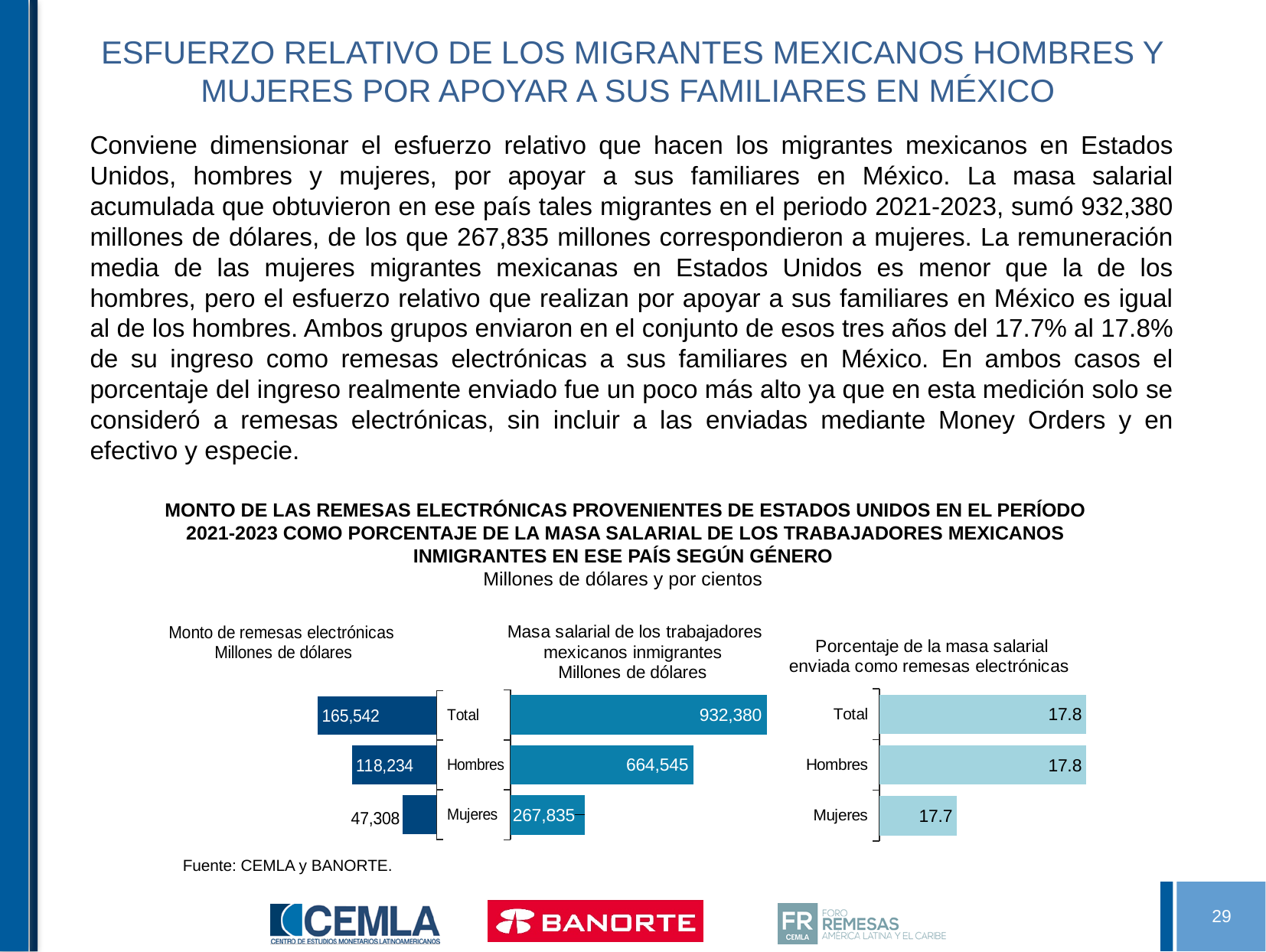
In the 'Monto de remesas electrónicas' chart, what is the value for Hombres? 118,234 In the 'Monto de remesas electrónicas' chart, which category has the lowest value? Mujeres In the 'Masa salarial de los trabajadores mexicanos inmigrantes' chart, what is the value for Mujeres? 267,835 In the 'Porcentaje de la masa salarial enviada como remesas electrónicas' chart, what is the value for Hombres? 17.8 In the 'Masa salarial de los trabajadores mexicanos inmigrantes' chart, which is larger, the value for Hombres or the value for Mujeres? Hombres In the 'Monto de remesas electrónicas' chart, what is the difference between the values for Hombres and Mujeres? 70,926 In the 'Masa salarial de los trabajadores mexicanos inmigrantes' chart, what is the value for Total? 932,380 What kind of chart is the 'Porcentaje de la masa salarial enviada como remesas electrónicas' chart? Bar chart In the 'Masa salarial de los trabajadores mexicanos inmigrantes' chart, which category has the highest value? Total In the 'Monto de remesas electrónicas' chart, what is the value for Mujeres? 47,308 In the 'Porcentaje de la masa salarial enviada como remesas electrónicas' chart, what is the value for Mujeres? 17.7 How many categories are shown in the 'Monto de remesas electrónicas' chart? 3